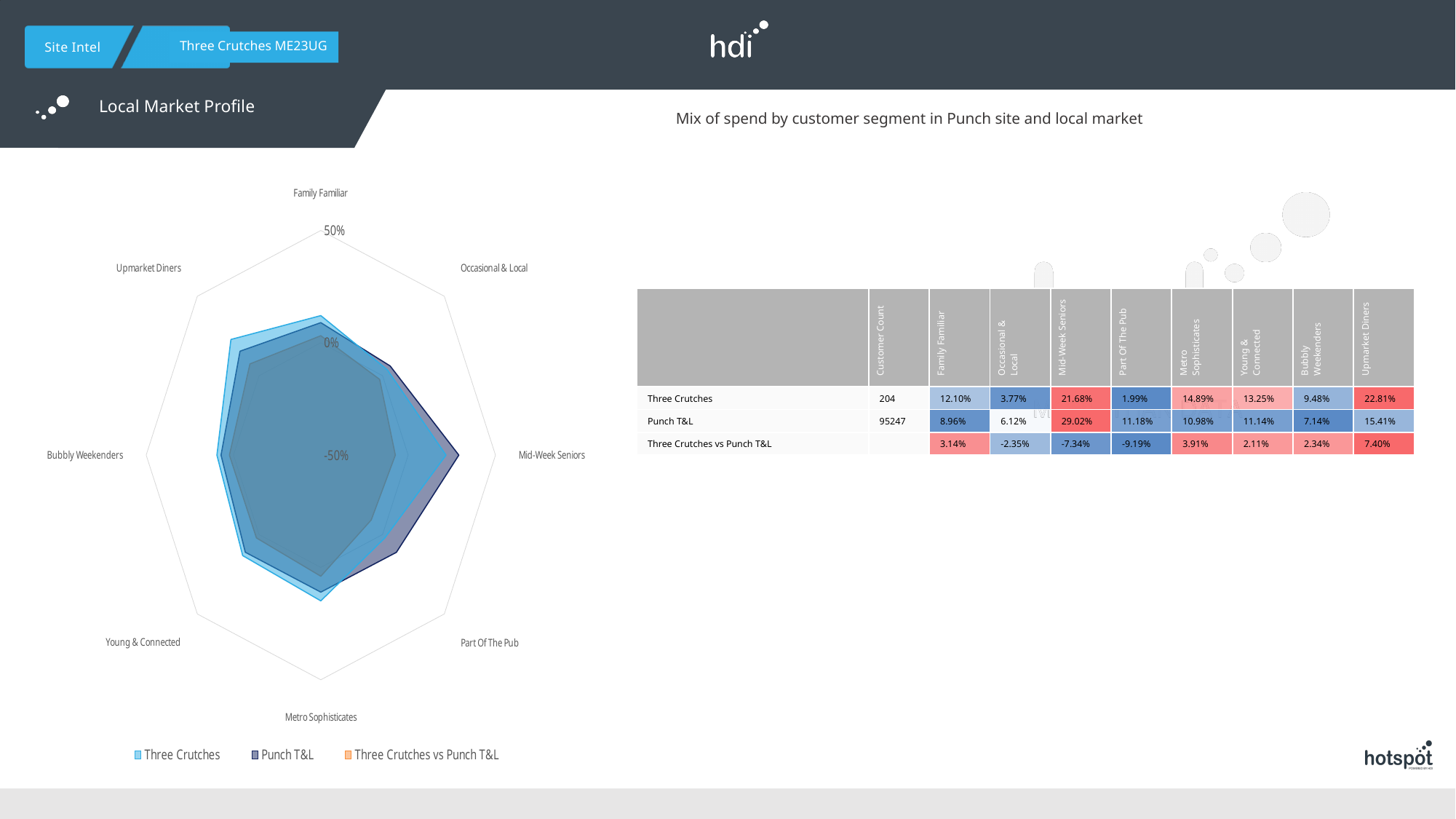
How many series does the radar chart's legend list? 3 According to the table, what is the Punch T&L value for Mid-Week Seniors? 29.02% What is the difference between the Punch T&L and Three Crutches values for Part Of The Pub? 9.19% Which customer segment has the lowest Three Crutches value? Part Of The Pub What kind of chart is shown on the left of the slide? Radar chart What is the customer count for Three Crutches shown in the table? 204 Which customer segment has the highest Punch T&L value? Mid-Week Seniors Which customer segment has the highest Three Crutches value? Upmarket Diners According to the table, what is the Three Crutches value for Upmarket Diners? 22.81% What is the highest value labelled on the radar chart's axis scale? 50% For Mid-Week Seniors, which is larger: the Three Crutches value or the Punch T&L value? Punch T&L How many customer segments (axes) does the radar chart have? 8